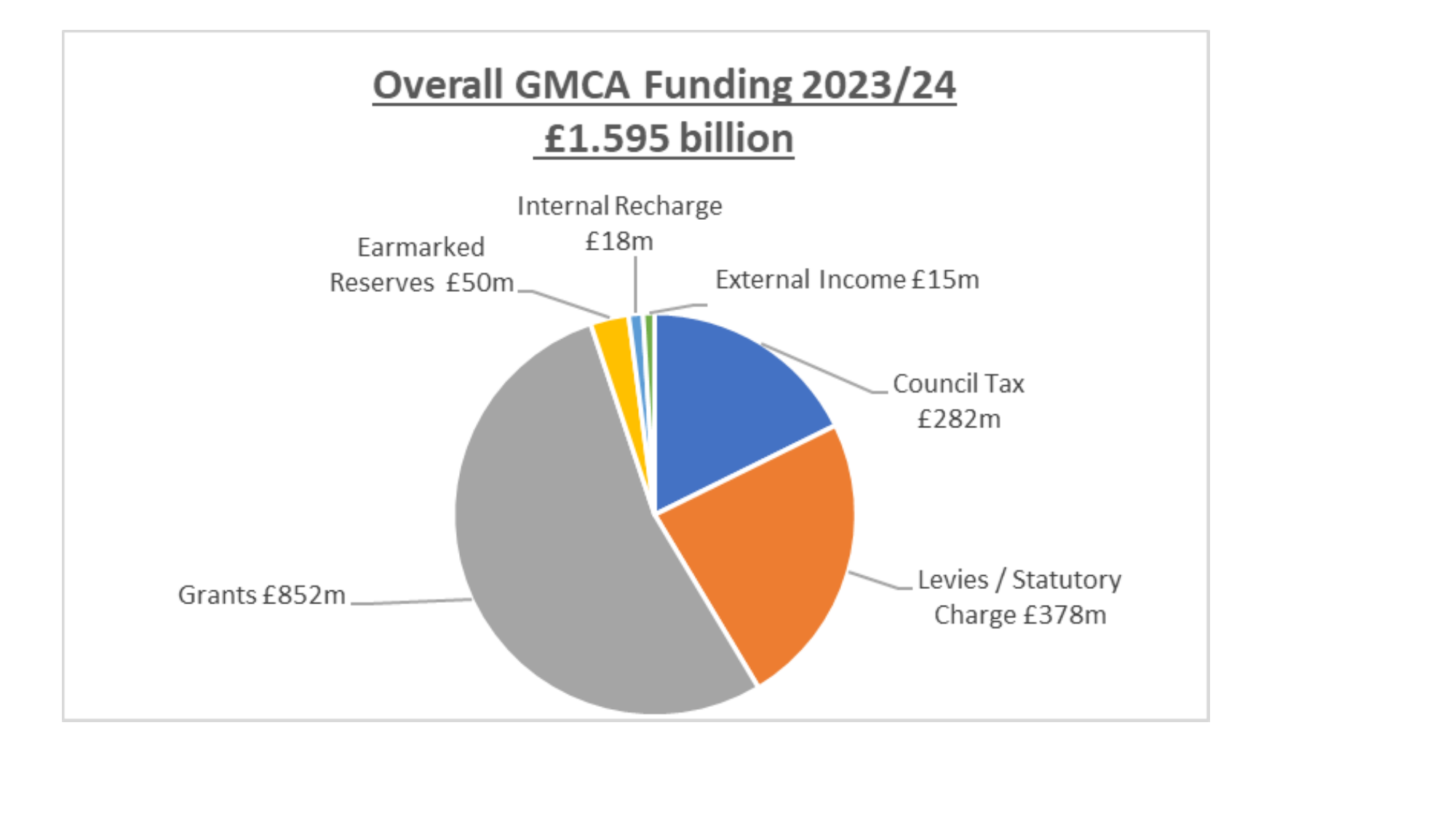
What is the value for Grants? £852m What colour is the Grants slice? grey What is the value for Council Tax? £282m What is the value for Levies / Statutory Charge? £378m What is the title of the chart? Overall GMCA Funding 2023/24 £1.595 billion What is the difference between Grants and Levies / Statutory Charge? £474m What is the value for Earmarked Reserves? £50m Which is larger, Council Tax or Levies / Statutory Charge? Levies / Statutory Charge How many slices does the pie chart have? 6 Which category has the largest slice of the pie? Grants What type of chart is shown on the slide? pie chart Which category has the smallest slice of the pie? External Income